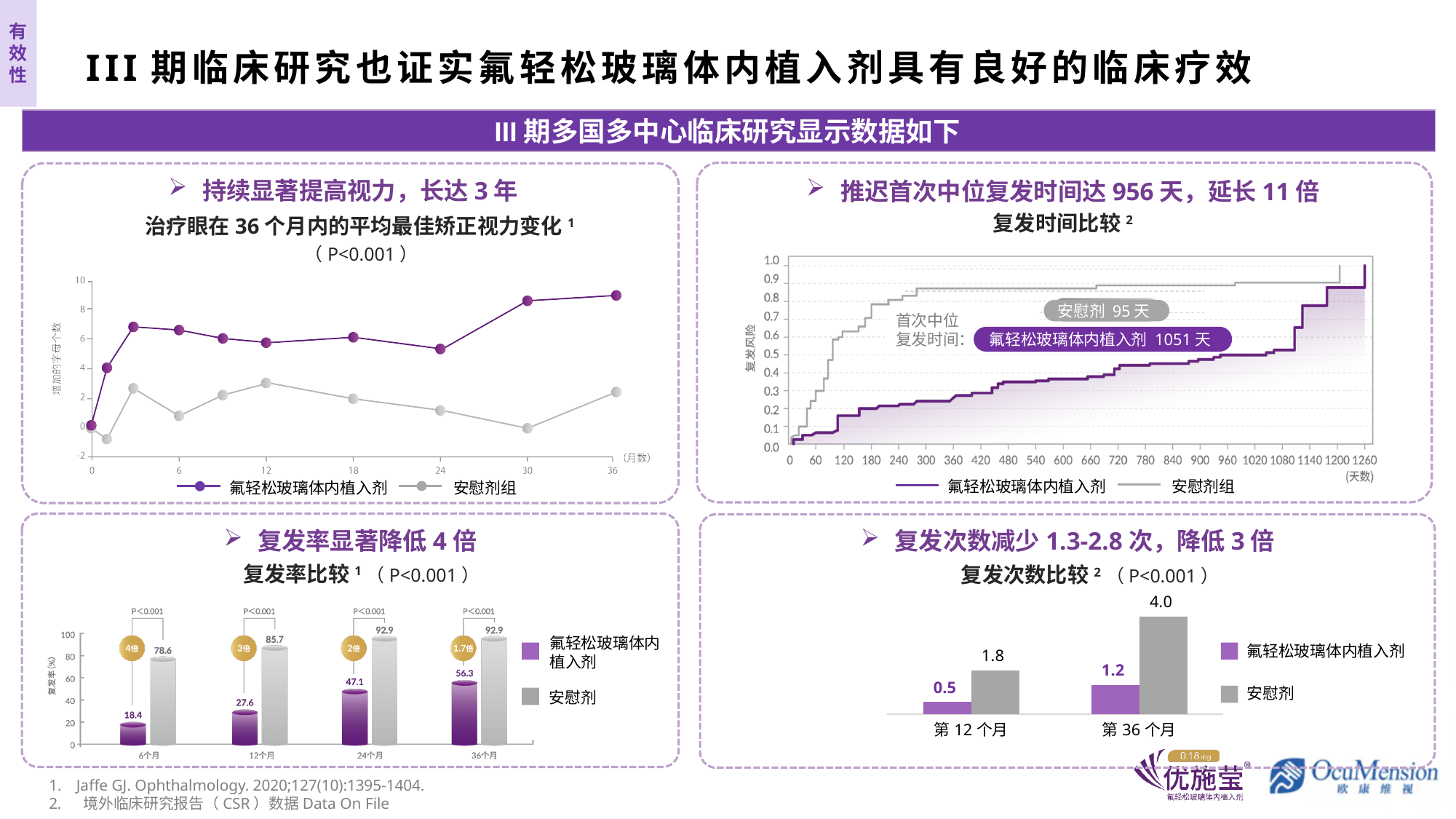
In the 复发次数比较 chart (bottom right), what is the value for 安慰剂 at 第 36 个月? 4.0 In the 复发次数比较 chart (bottom right), what is the difference between 安慰剂 and 氟轻松玻璃体内植入剂 at 第 36 个月? 2.8 In the 复发次数比较 chart (bottom right), which series has the larger value at 第 12 个月? 安慰剂 In the 复发率比较 chart (bottom left), what is the recurrence rate for 安慰剂 at 36个月? 92.9 What kind of chart is the 治疗眼在 36 个月内的平均最佳矫正视力变化 chart (top left)? line chart In the 复发时间比较 chart (top right), what is the median time to first recurrence shown for 氟轻松玻璃体内植入剂? 1051 天 In the 复发率比较 chart (bottom left), how many time-point categories are shown on the x axis? 4 In the 复发率比较 chart (bottom left), at which time point is the 氟轻松玻璃体内植入剂 recurrence rate highest? 36个月 In the 治疗眼在 36 个月内的平均最佳矫正视力变化 chart (top left), is the value for 氟轻松玻璃体内植入剂 at month 36 greater or less than 8? greater In the 复发率比较 chart (bottom left), what is the recurrence rate for 氟轻松玻璃体内植入剂 at 6个月? 18.4 In the 复发次数比较 chart (bottom right), what is the value for 氟轻松玻璃体内植入剂 at 第 12 个月? 0.5 In the 复发率比较 chart (bottom left), what is the difference between the 安慰剂 and 氟轻松玻璃体内植入剂 values at 12个月? 58.1